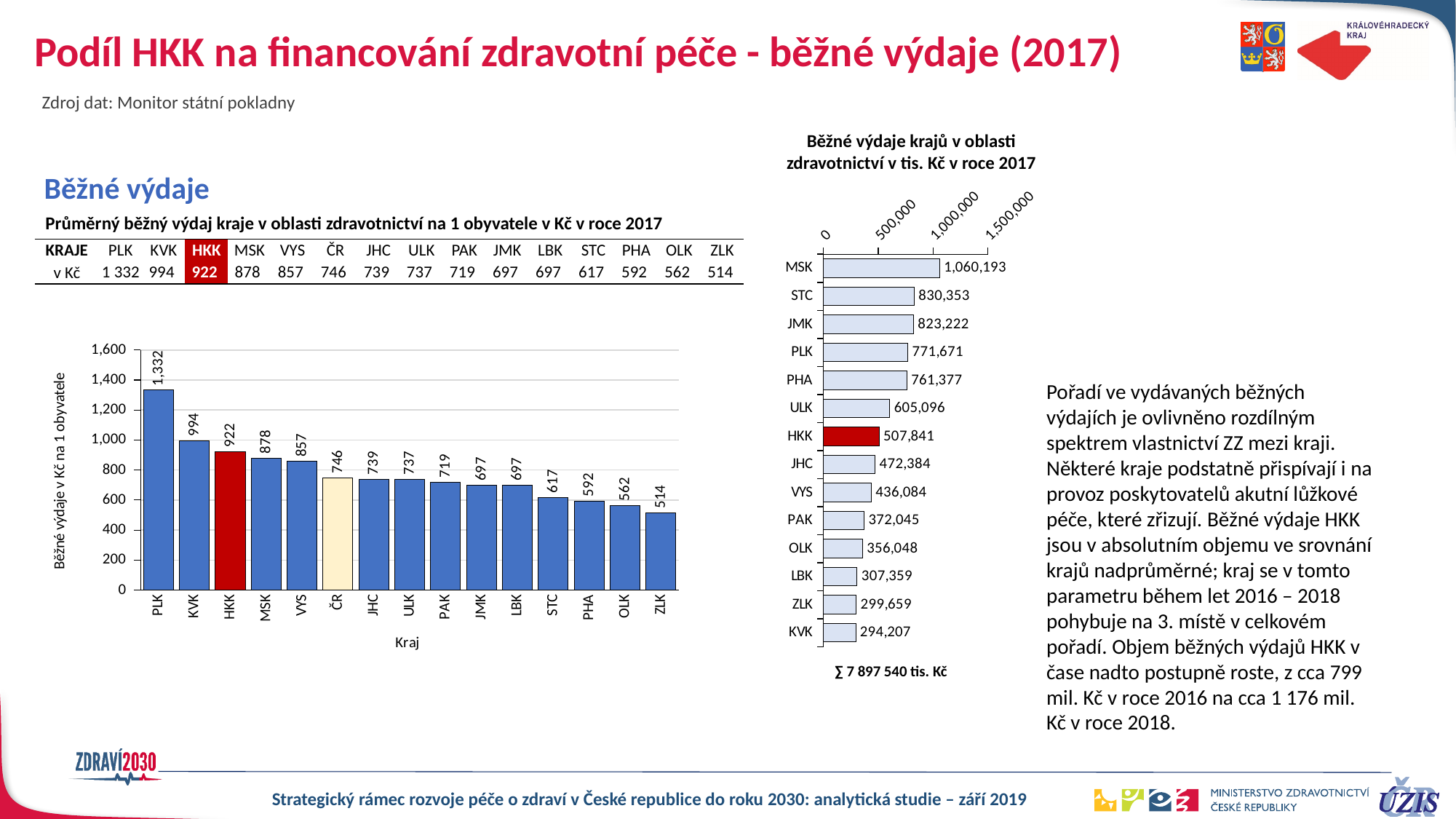
What type of chart is the left chart (Běžné výdaje v Kč na 1 obyvatele)? Bar chart In the left chart (Běžné výdaje v Kč na 1 obyvatele), which region has the lowest value? ZLK In the right chart (Běžné výdaje krajů v oblasti zdravotnictví v tis. Kč v roce 2017), what is the value for HKK? 507,841 In the left chart (Běžné výdaje v Kč na 1 obyvatele), do the values rise or fall from left to right along the x axis? Fall In the left chart (Běžné výdaje v Kč na 1 obyvatele), what is the value for HKK? 922 In the right chart (Běžné výdaje krajů v oblasti zdravotnictví v tis. Kč v roce 2017), which region has the highest value? MSK In the left chart (Běžné výdaje v Kč na 1 obyvatele), how many bars are plotted? 15 In the left chart (Běžné výdaje v Kč na 1 obyvatele), what is the difference between the values for PLK and KVK? 338 In the right chart (Běžné výdaje krajů v oblasti zdravotnictví v tis. Kč v roce 2017), how many regions are plotted? 14 In the right chart (Běžné výdaje krajů v oblasti zdravotnictví v tis. Kč v roce 2017), which region has the lowest value? KVK In the left chart (Běžné výdaje v Kč na 1 obyvatele), which region has the highest value? PLK In the right chart (Běžné výdaje krajů v oblasti zdravotnictví v tis. Kč v roce 2017), which is larger, the value for STC or the value for ULK? STC